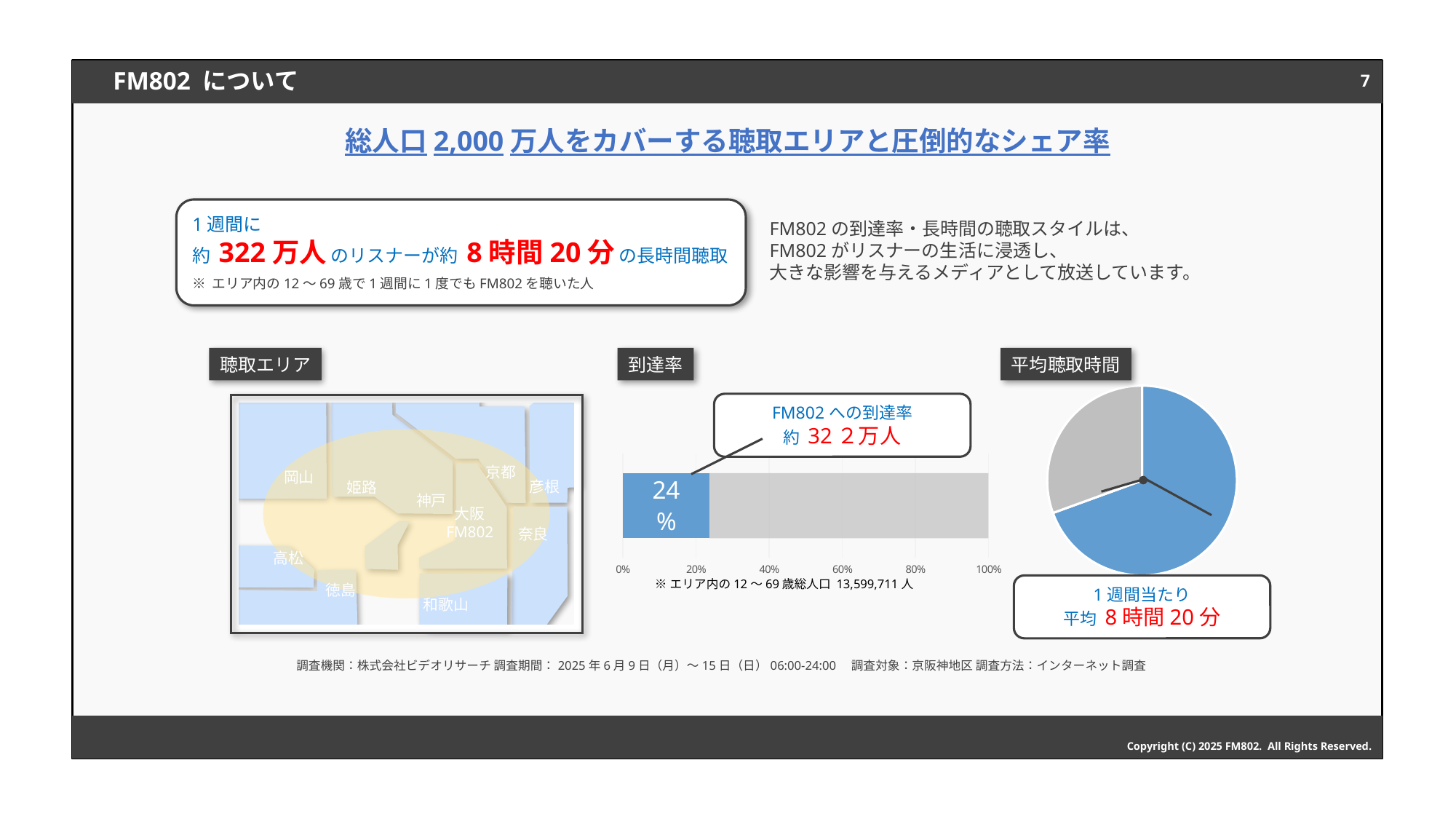
In the 到達率 chart, what is the highest value shown on the x axis? 100% In the 到達率 chart, what number of people does the callout give for FM802 への到達率? 約 32 2万人 How many slices does the 平均聴取時間 pie chart have? 2 In the 到達率 chart, what value is printed on the blue bar? 24% What kind of chart is the 平均聴取時間 chart? pie chart In the 平均聴取時間 pie chart, which slice is larger, the blue one or the grey one? blue In the 到達率 chart, is the value of the blue bar greater or less than 40%? less In the 到達率 chart, is the value of the blue bar greater or less than 20%? greater In the 平均聴取時間 pie chart, is the blue slice more or less than half of the pie? more What kind of chart is the 到達率 chart? bar chart